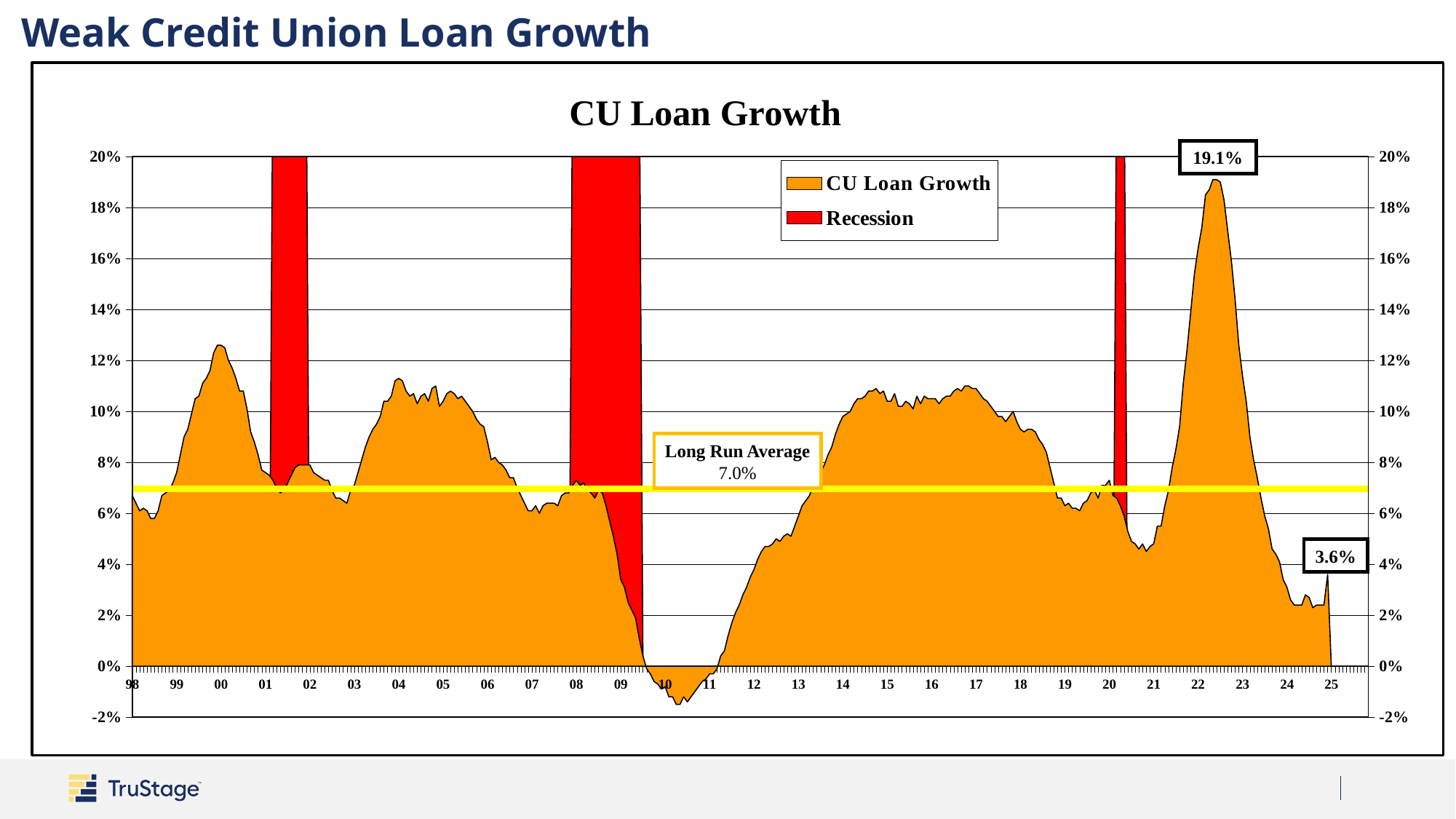
Does CU loan growth rise or fall between 2022 and 2025? fall What is the peak value of CU loan growth labeled on the chart? 19.1% Is the latest CU loan growth value of 3.6% greater or less than the long run average of 7.0%? less How many series does the legend list? 2 What is the most recent CU loan growth value labeled on the chart, at 2025? 3.6% Which series is shown in red in the legend? Recession What is the title of the chart? CU Loan Growth Is the CU loan growth value around 2010 greater or less than 0%? less What is the difference between the labeled peak value of 19.1% and the latest value of 3.6%? 15.5% How many recession periods are shaded on the chart? 3 What is the long run average of CU loan growth shown on the chart? 7.0% Is the CU loan growth value around 2016 greater or less than 8%? greater